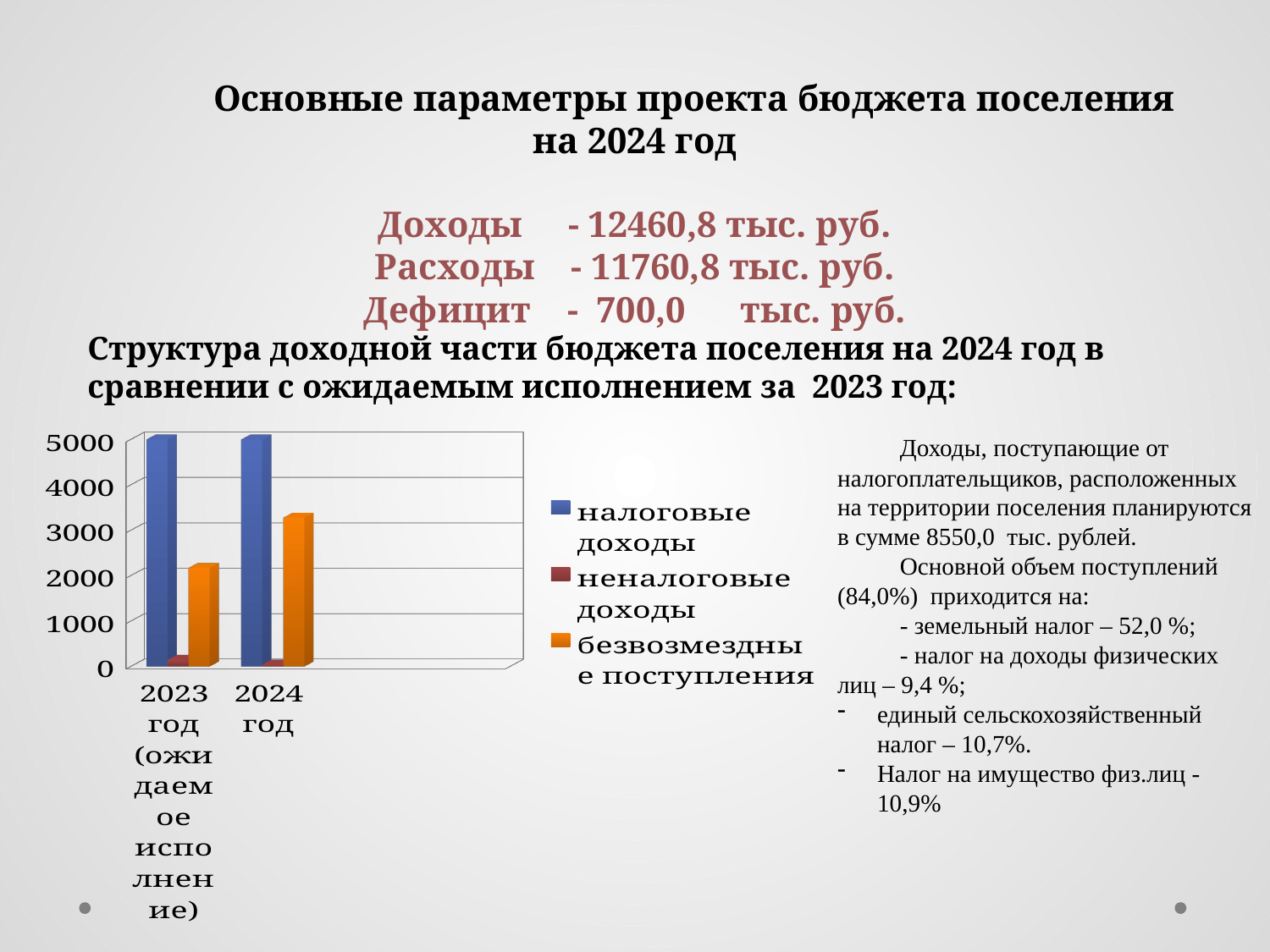
Which is larger: безвозмездные поступления in 2023 год (ожидаемое исполнение) or in 2024 год? 2024 год How many year categories are shown on the x axis of the chart? 2 What is the highest tick value shown on the vertical axis of the chart? 5000 Do the values for безвозмездные поступления rise or fall from 2023 год to 2024 год? rise Which series has the highest value in 2023 год (ожидаемое исполнение)? налоговые доходы Is the value for безвозмездные поступления in 2023 год (ожидаемое исполнение) greater or less than 3000? less Is the value for безвозмездные поступления in 2024 год greater or less than 3000? greater What colour represents налоговые доходы in the chart legend? blue How many series does the chart legend list? 3 Which series has the lowest value in 2024 год? неналоговые доходы What kind of chart is shown on the slide? bar chart Is the value for неналоговые доходы in 2023 год (ожидаемое исполнение) greater or less than 1000? less